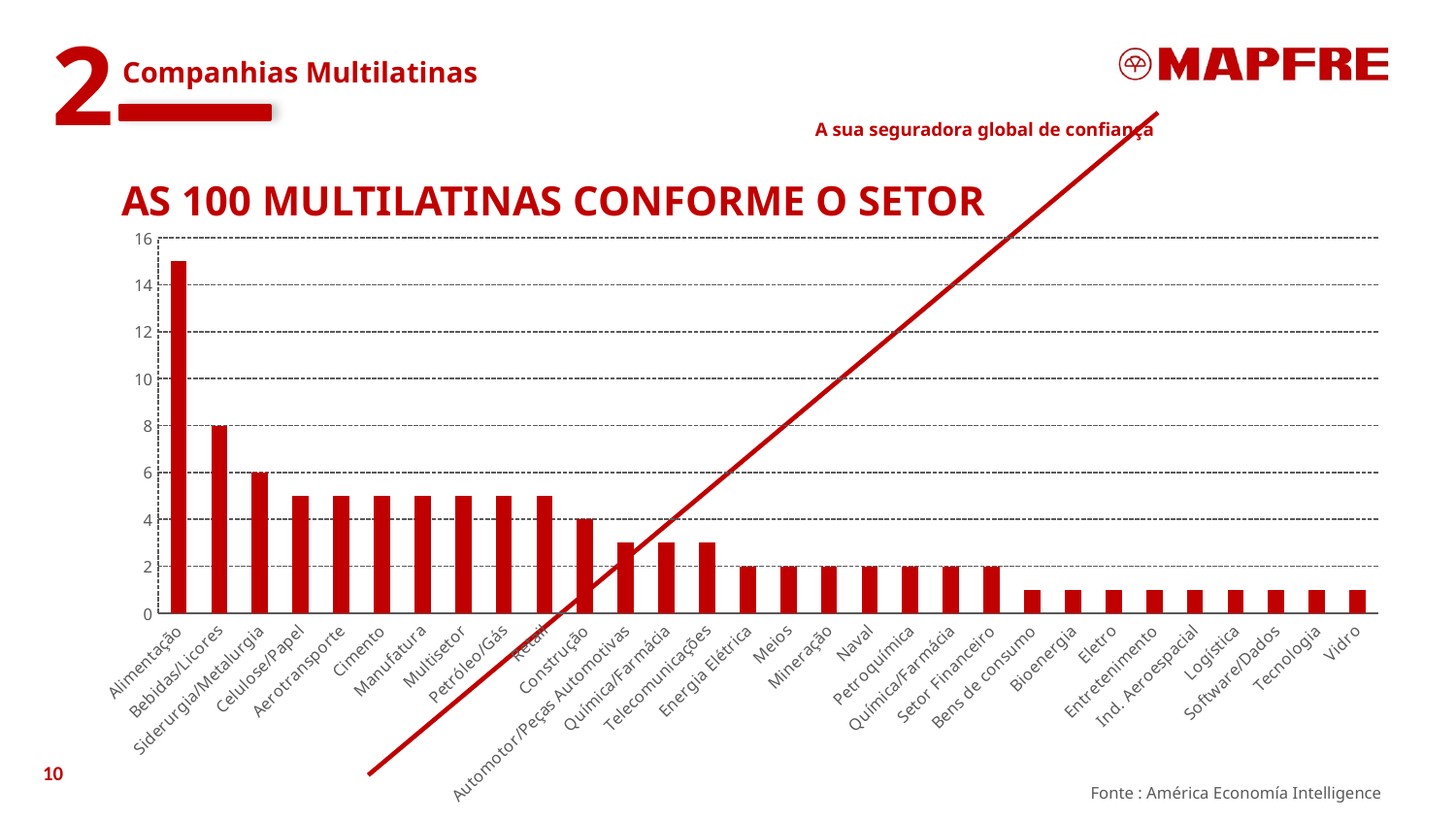
What kind of chart is shown on the slide? bar chart Do the bar values rise or fall from left to right along the x axis? fall What is the value for Bebidas/Licores? 8 What is the value for Siderurgia/Metalurgia? 6 What is the value for Energia Elétrica? 2 Is the value for Cimento greater or less than 4? greater Which is larger, the value for Bebidas/Licores or the value for Construção? Bebidas/Licores What is the value for Construção? 4 Which sector has the highest bar in the chart? Alimentação What is the difference between the values for Bebidas/Licores and Siderurgia/Metalurgia? 2 What is the title of the chart? AS 100 MULTILATINAS CONFORME O SETOR Is the value for Alimentação greater or less than 14? greater